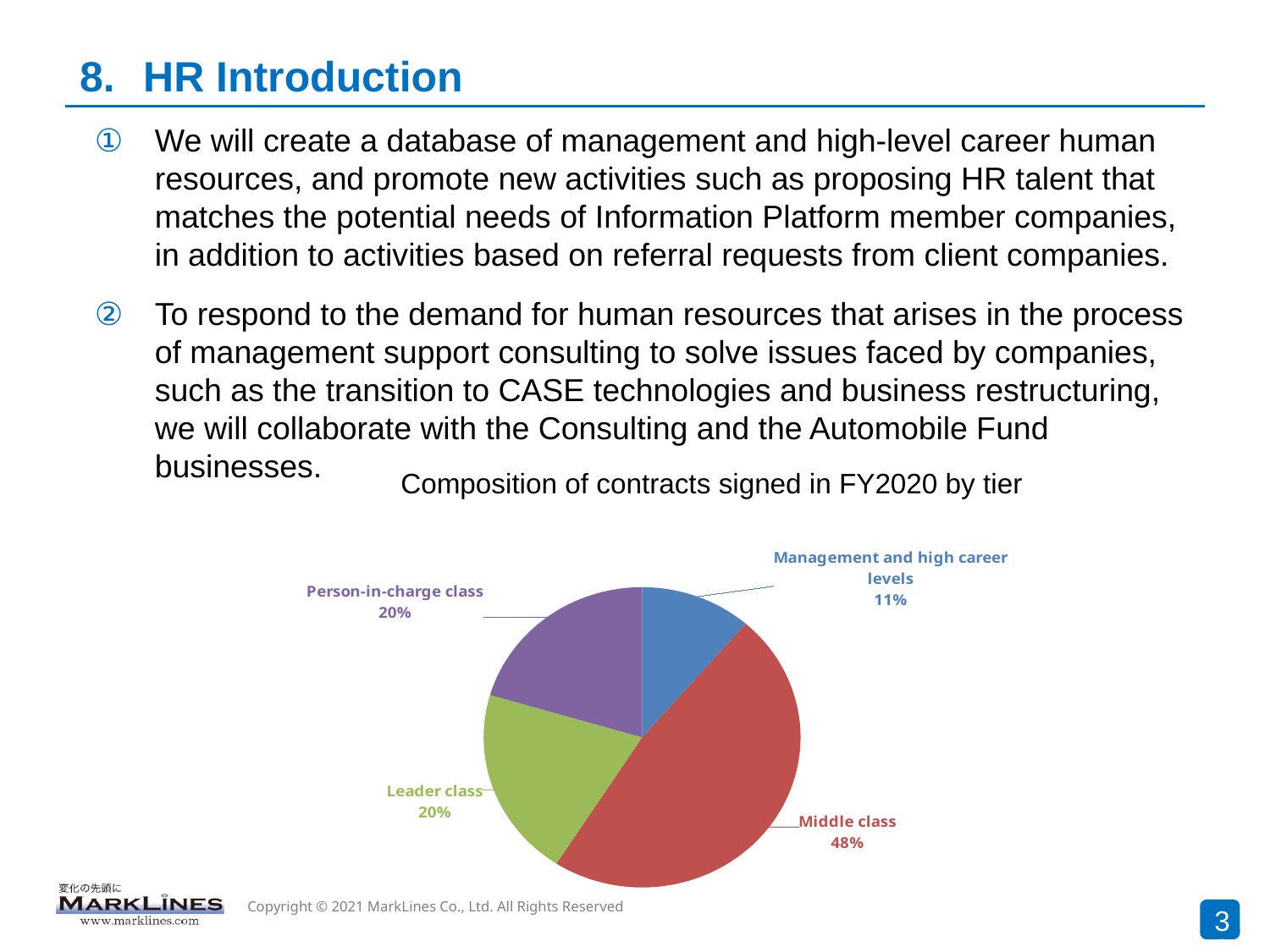
What share of contracts does the Management and high career levels slice represent? 11% Which tier has the smallest share of contracts? Management and high career levels What is the difference in percentage points between the Middle class share and the Management and high career levels share? 37 percentage points What colour is the Middle class slice? Red What share of contracts does the Leader class slice represent? 20% What kind of chart is shown on the slide? Pie chart Which tier has the largest share of contracts? Middle class What is the title of the chart? Composition of contracts signed in FY2020 by tier Which is larger, the Middle class share or the Leader class share? Middle class How many tiers are shown in the pie chart? 4 What share of contracts does the Middle class slice represent? 48% What share of contracts does the Person-in-charge class slice represent? 20%